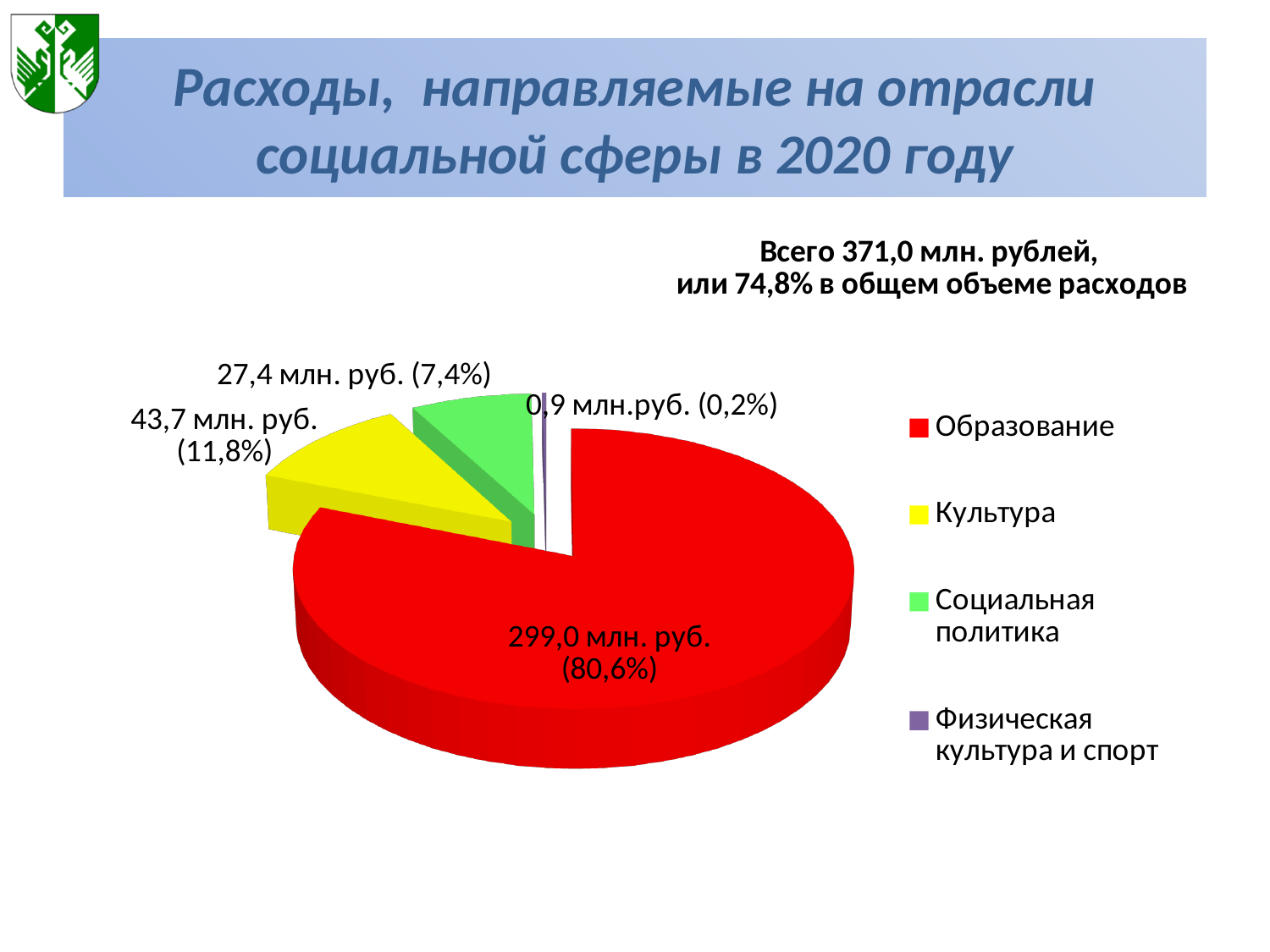
Which is larger, the value for Культура or the value for Социальная политика? Культура What share of the pie does Образование take? 80,6% How many categories does the legend of the pie chart list? 4 Which category has the largest slice of the pie? Образование What kind of chart is shown on the slide? pie chart What is the value shown for Социальная политика? 27,4 млн. руб. What colour is the slice for Образование? red What share of the pie does Культура take? 11,8% What is the value shown for Физическая культура и спорт? 0,9 млн.руб. What is the value shown for Культура? 43,7 млн. руб. Which category has the smallest slice of the pie? Физическая культура и спорт What is the value shown for Образование? 299,0 млн. руб.